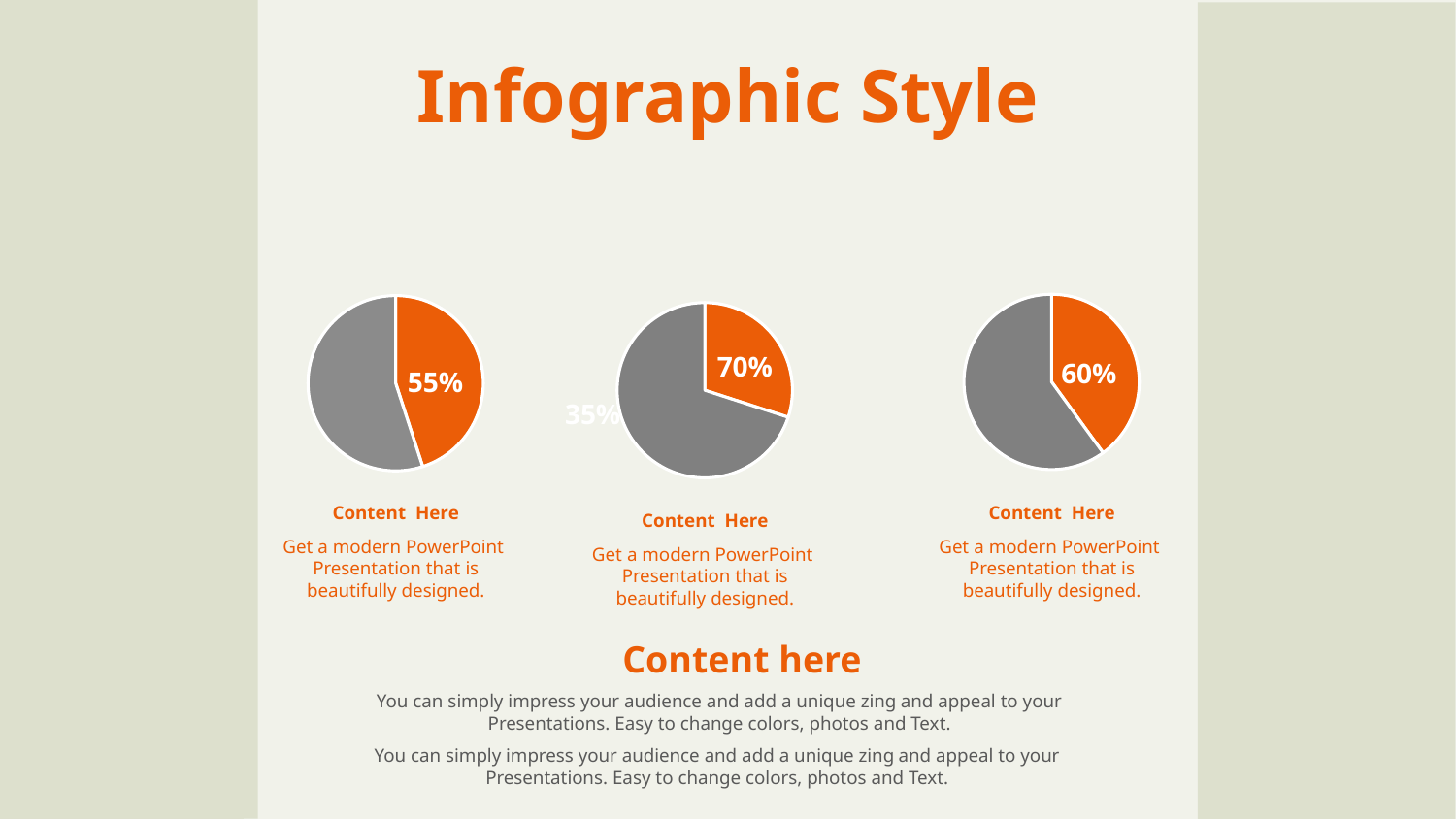
In the middle pie chart, what value is printed on the orange slice? 70% What colour is the slice that carries the percentage label in each pie chart? orange What colour is the unlabeled slice in the right pie chart? gray In the left pie chart, what value is printed on the orange slice? 55% How many slices does the left pie chart have? 2 How many pie charts are shown on the slide? 3 In the right pie chart, what value is printed on the orange slice? 60% What kind of chart is the left chart on the slide? pie chart Which pie chart has the highest value printed on its orange slice: left, middle or right? middle Is the value printed on the orange slice larger in the left pie chart or the right pie chart? right What is the difference between the value printed on the right pie chart's orange slice and the value printed on the left pie chart's orange slice? 5 percentage points Which pie chart has the lowest value printed on its orange slice: left, middle or right? left